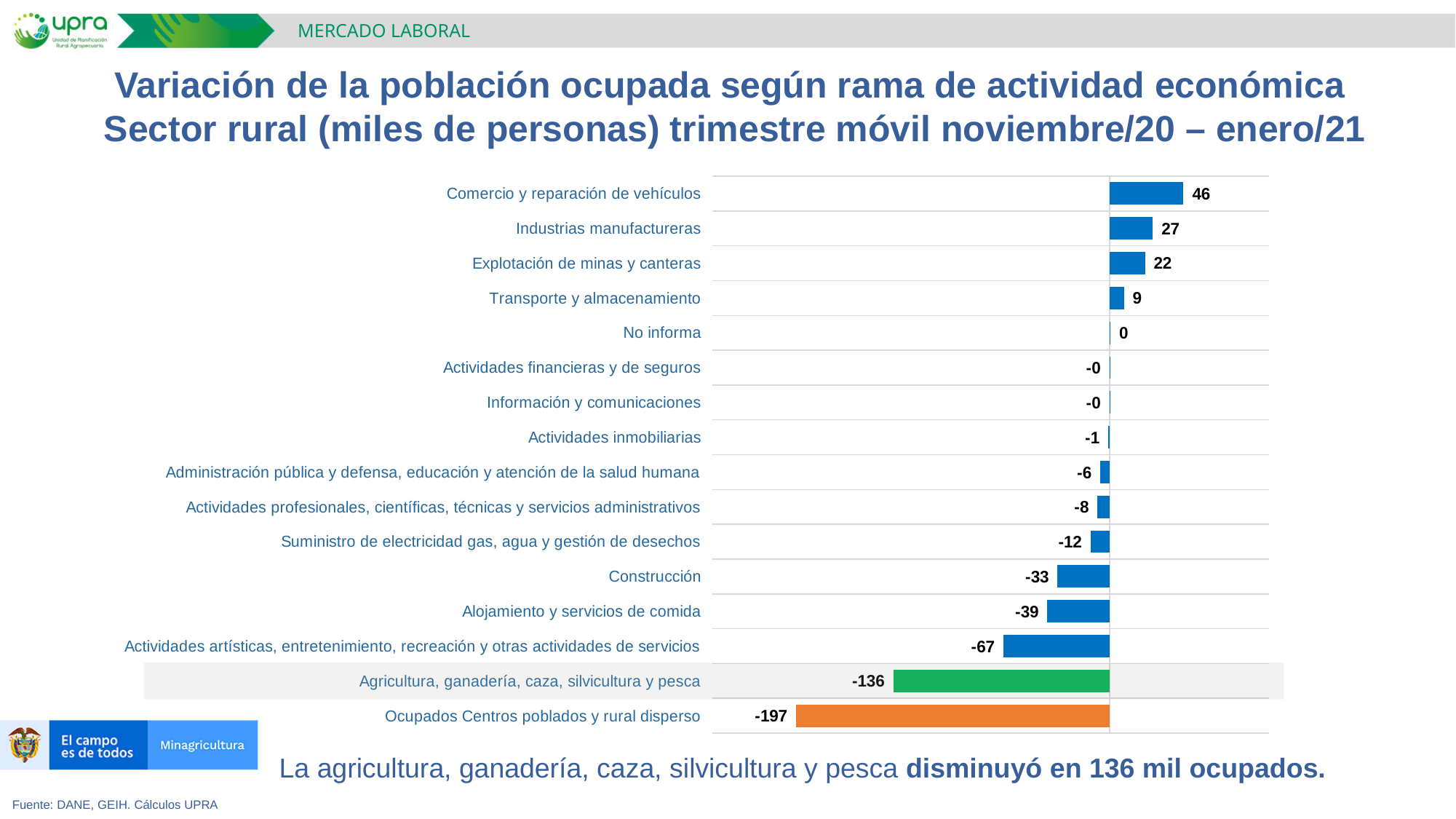
What colour is the bar for Agricultura, ganadería, caza, silvicultura y pesca? Green How many categories are shown in the chart? 16 Which category has the lowest value? Ocupados Centros poblados y rural disperso Which category has the highest value? Comercio y reparación de vehículos What is the value for Explotación de minas y canteras? 22 What is the value for Construcción? -33 What is the value for Ocupados Centros poblados y rural disperso? -197 What is the value for Agricultura, ganadería, caza, silvicultura y pesca? -136 What is the value for Comercio y reparación de vehículos? 46 What is the difference between the values for Comercio y reparación de vehículos and Industrias manufactureras? 19 What kind of chart is shown on the slide? Bar chart Which has the larger value, Construcción or Alojamiento y servicios de comida? Construcción